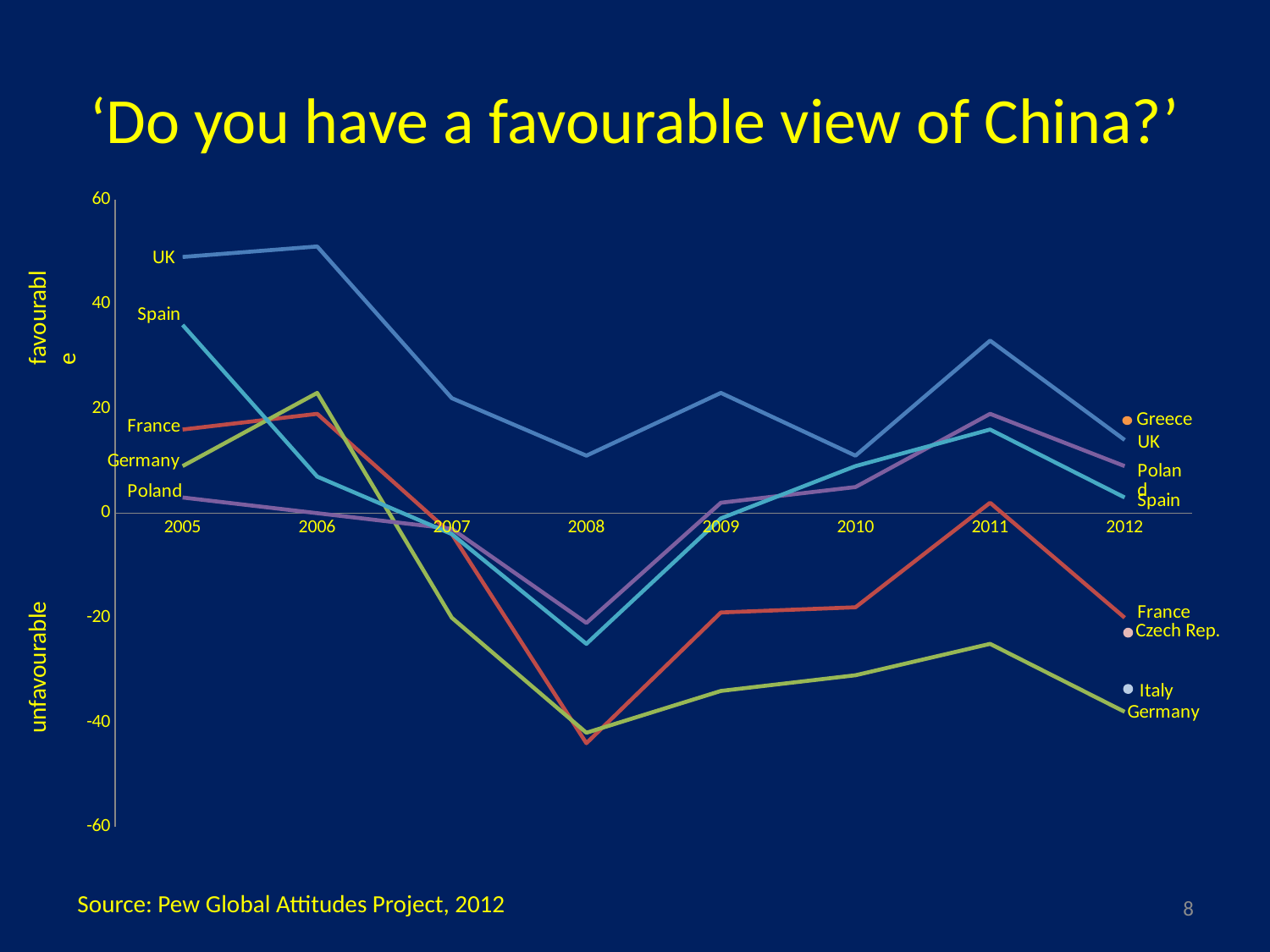
In 2012, which is higher, the UK line or the Germany line? UK What is the source cited at the bottom of the slide? Pew Global Attitudes Project, 2012 How many years are shown on the x axis of the chart? 8 How many countries are plotted as lines across the years in the chart? 5 Is the value for Germany in 2008 greater or less than -20? less Does the UK line rise or fall between 2006 and 2008? Fall Is the value for Spain in 2005 greater or less than 20? greater Is the value for the UK in 2006 greater or less than 40? greater In which year does the France line reach its lowest value? 2008 What kind of chart is shown on the slide? Line chart Which country has the highest value in 2005? UK